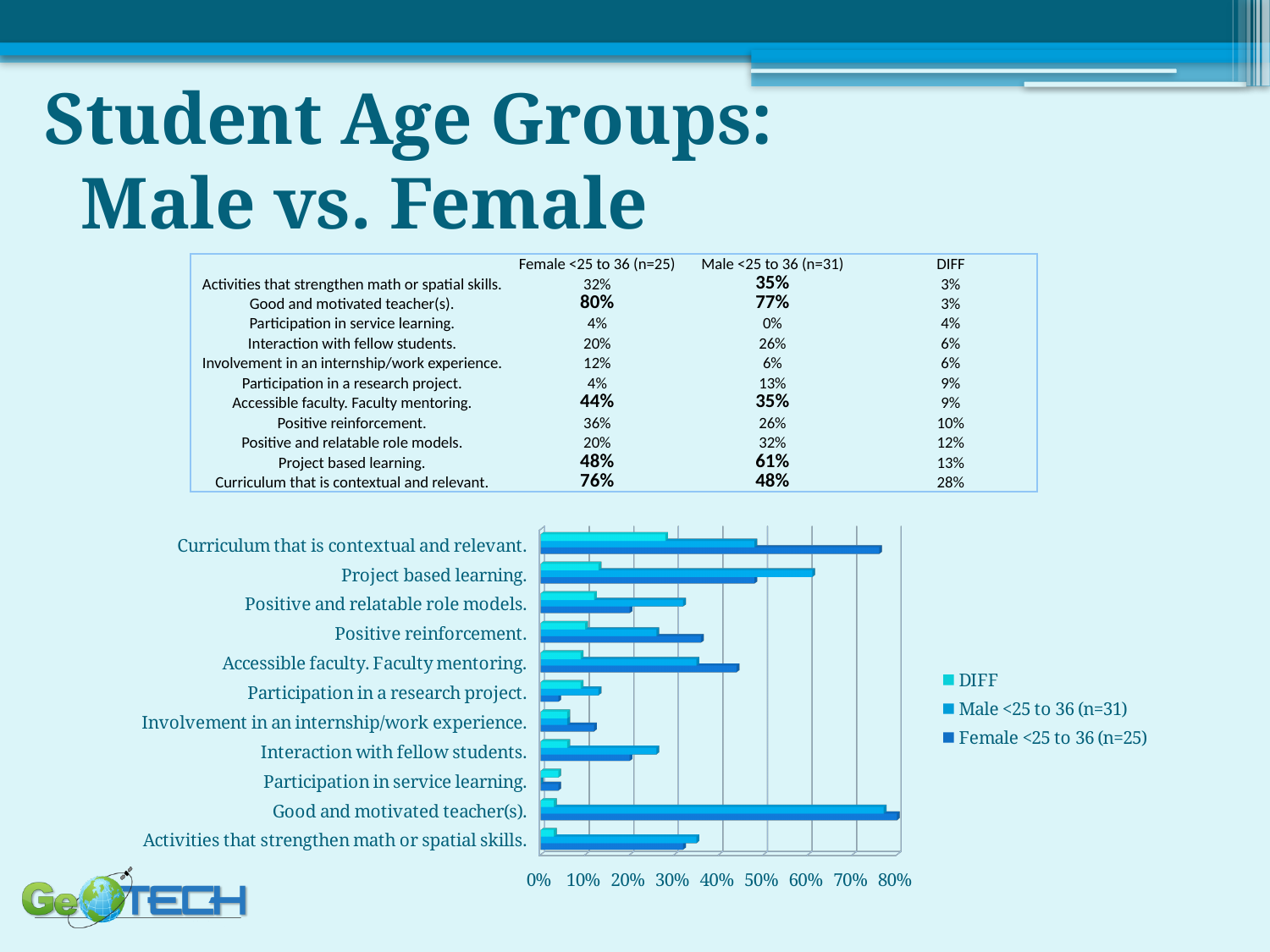
Which category has the largest DIFF value? Curriculum that is contextual and relevant. According to the table, what is the Female <25 to 36 (n=25) value for 'Curriculum that is contextual and relevant.'? 76% Which category has the lowest Male <25 to 36 (n=31) value? Participation in service learning. According to the table, what is the DIFF value for 'Positive and relatable role models.'? 12% What is the difference between the Female and Male values for 'Accessible faculty. Faculty mentoring.'? 9% Is the Male <25 to 36 (n=31) bar for 'Good and motivated teacher(s).' greater or less than 70%? greater What kind of chart is shown on the slide? bar chart Which category has the highest Female <25 to 36 (n=25) value? Good and motivated teacher(s). According to the table, what is the Male <25 to 36 (n=31) value for 'Project based learning.'? 61% How many series does the chart's legend list? 3 How many categories are plotted on the chart? 11 Which is larger for 'Interaction with fellow students.': the Female <25 to 36 (n=25) value or the Male <25 to 36 (n=31) value? Male <25 to 36 (n=31)